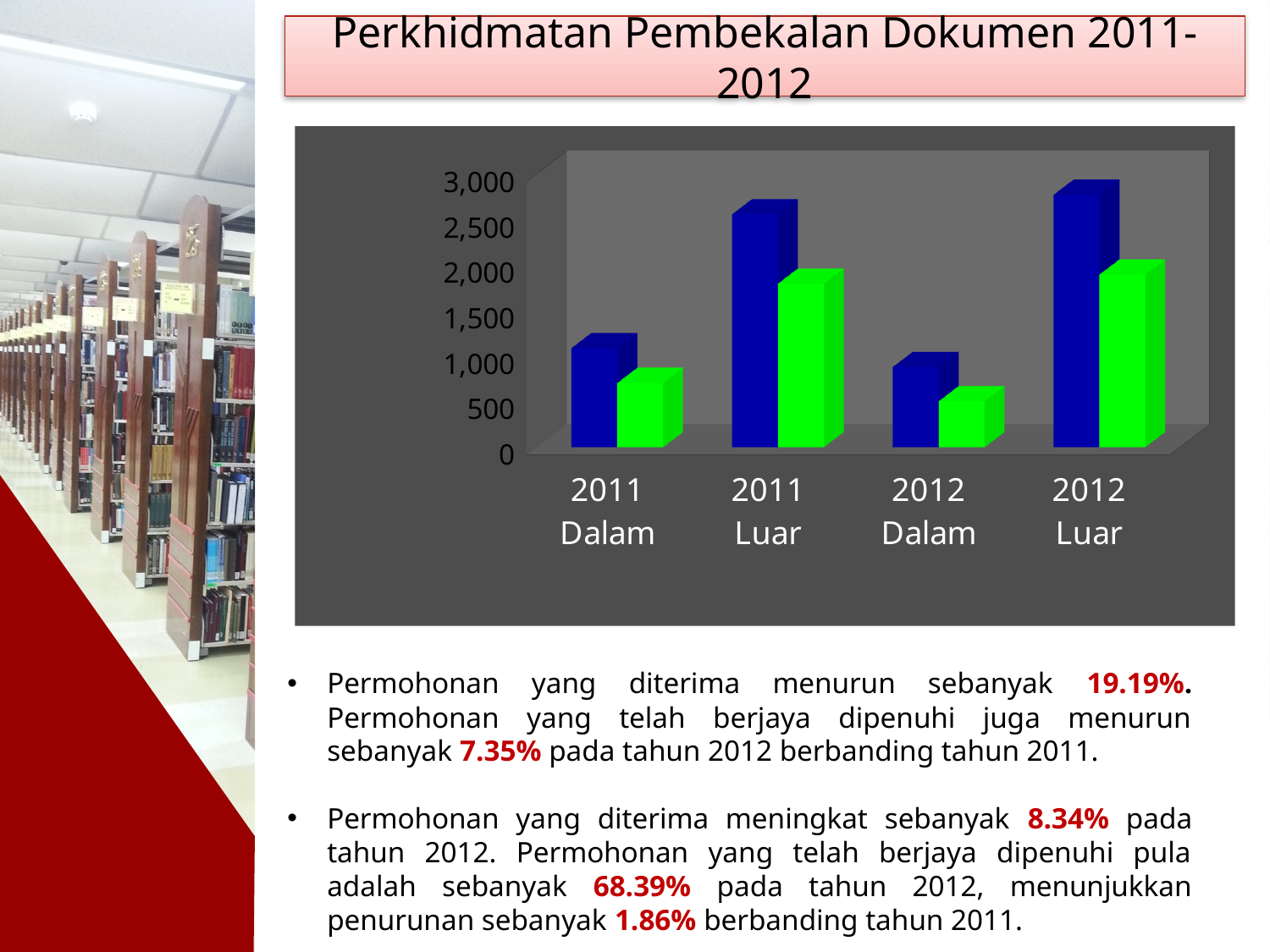
What is the highest value shown on the vertical axis of the chart? 3,000 How many bars are plotted for each category in the chart? 2 Which category has the tallest blue bar? 2012 Luar For 2011 Luar, which bar is taller, the blue bar or the green bar? the blue bar Is the blue bar for 2012 Dalam greater or less than 1,500? less What kind of chart is shown on the slide? bar chart How many categories are shown on the x axis of the chart? 4 Which category has the shortest green bar? 2012 Dalam Is the green bar for 2012 Dalam greater or less than 1,000? less Which category has the shortest blue bar? 2012 Dalam Is the blue bar for 2011 Luar greater or less than 2,000? greater What is the title of the slide containing the chart? Perkhidmatan Pembekalan Dokumen 2011-2012